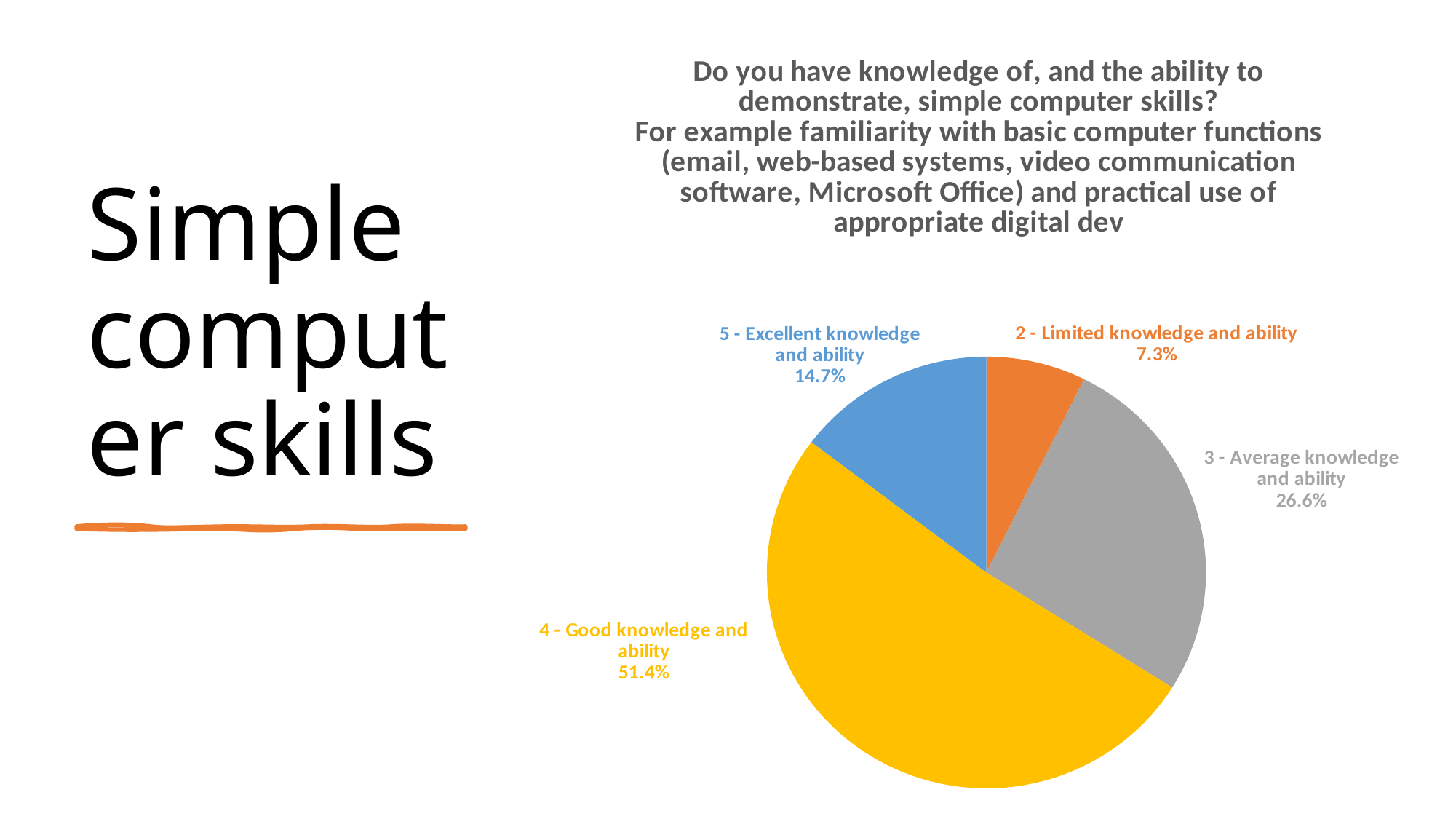
What share of the pie is labelled "4 - Good knowledge and ability"? 51.4% What share of the pie is labelled "2 - Limited knowledge and ability"? 7.3% Which is larger: the slice for "5 - Excellent knowledge and ability" or the slice for "2 - Limited knowledge and ability"? 5 - Excellent knowledge and ability What share of the pie is labelled "3 - Average knowledge and ability"? 26.6% What colour is the slice for "5 - Excellent knowledge and ability"? Blue What colour is the slice for "3 - Average knowledge and ability"? Grey Which category has the largest slice of the pie? 4 - Good knowledge and ability What is the difference in percentage points between "4 - Good knowledge and ability" and "3 - Average knowledge and ability"? 24.8 How many slices does the pie chart have? 4 Which category has the smallest slice of the pie? 2 - Limited knowledge and ability What share of the pie is labelled "5 - Excellent knowledge and ability"? 14.7% What kind of chart is shown on the slide? Pie chart